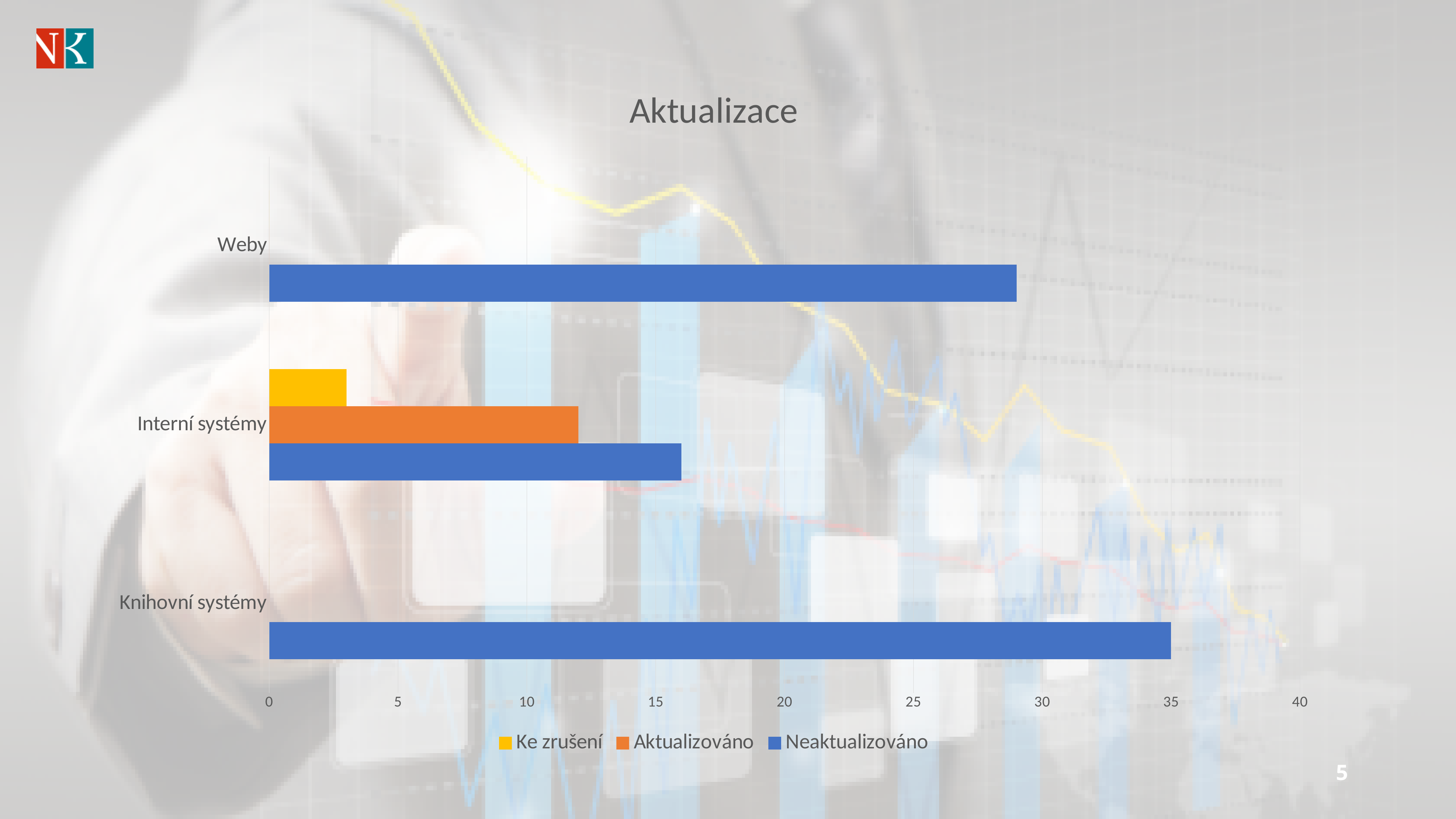
Is the Neaktualizováno value for Weby greater or less than 25? greater How many categories are shown on the vertical axis? 3 How many series does the legend list? 3 Is the Aktualizováno value for Interní systémy greater or less than 10? greater Which series has the smallest value for Interní systémy? Ke zrušení What is the Neaktualizováno value for Knihovní systémy? 35 What is the title of the chart? Aktualizace What type of chart is shown on the slide? bar chart Is the Neaktualizováno value for Interní systémy greater or less than 15? greater For Interní systémy, which is larger: Neaktualizováno or Aktualizováno? Neaktualizováno Which category has the highest Neaktualizováno value? Knihovní systémy